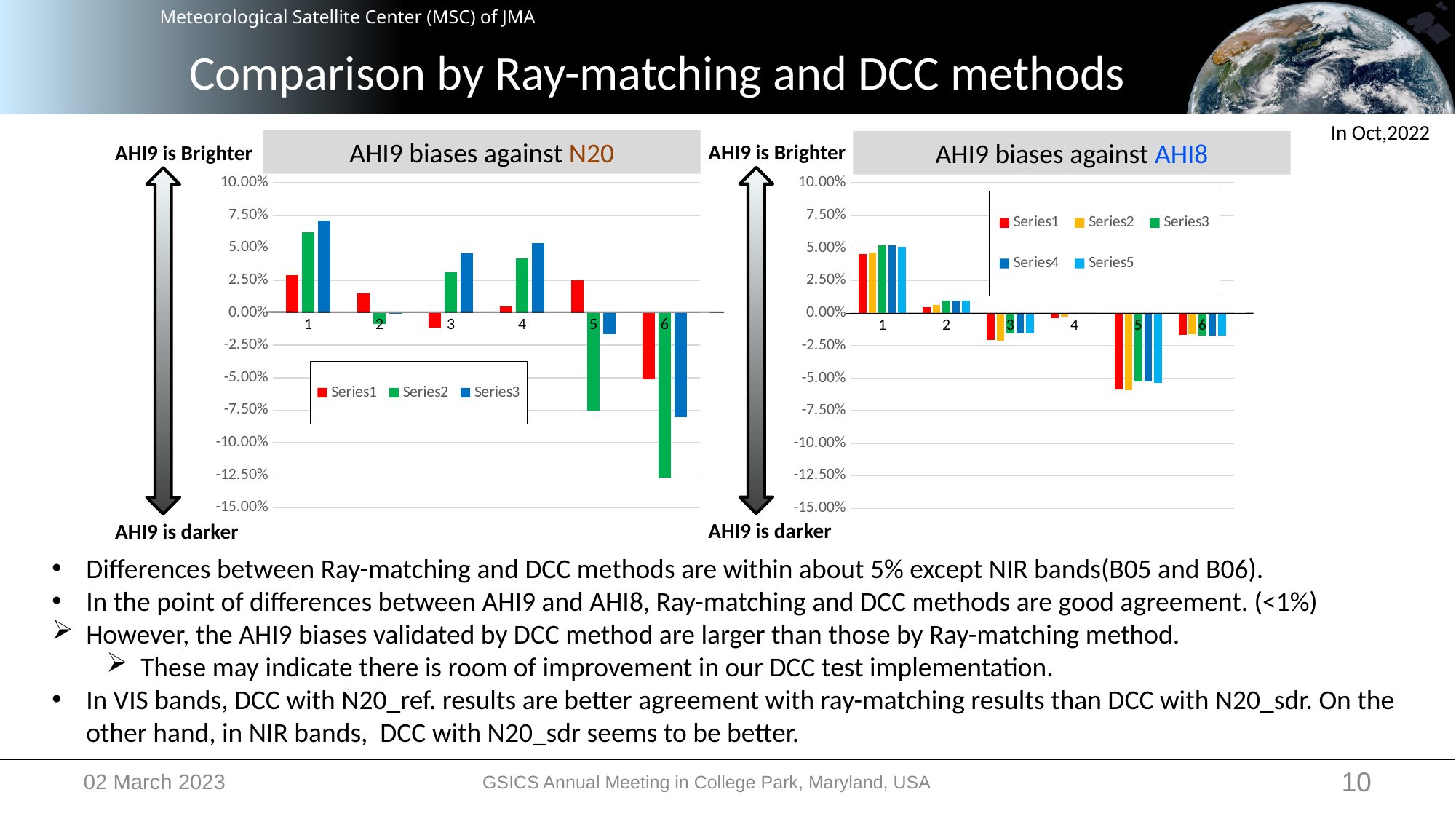
In the "AHI9 biases against N20" chart, which series has the lowest value at category 6? Series2 In the "AHI9 biases against AHI8" chart, which is larger for Series1: the value at category 1 or the value at category 2? category 1 What is the title of the chart on the right side of the slide? AHI9 biases against AHI8 In the "AHI9 biases against N20" chart, is the value of Series3 at category 1 greater or less than 5.00%? greater How many categories are shown on the x axis of the "AHI9 biases against AHI8" chart? 6 How many series does the legend of the "AHI9 biases against AHI8" chart list? 5 In the "AHI9 biases against N20" chart, is the value of Series2 at category 5 greater or less than -5.00%? less How many series does the legend of the "AHI9 biases against N20" chart list? 3 In the "AHI9 biases against N20" chart, which series has the highest value at category 1? Series3 In the "AHI9 biases against AHI8" chart, is the value of Series1 at category 1 greater or less than 5.00%? less What kind of chart is the "AHI9 biases against N20" chart? bar chart